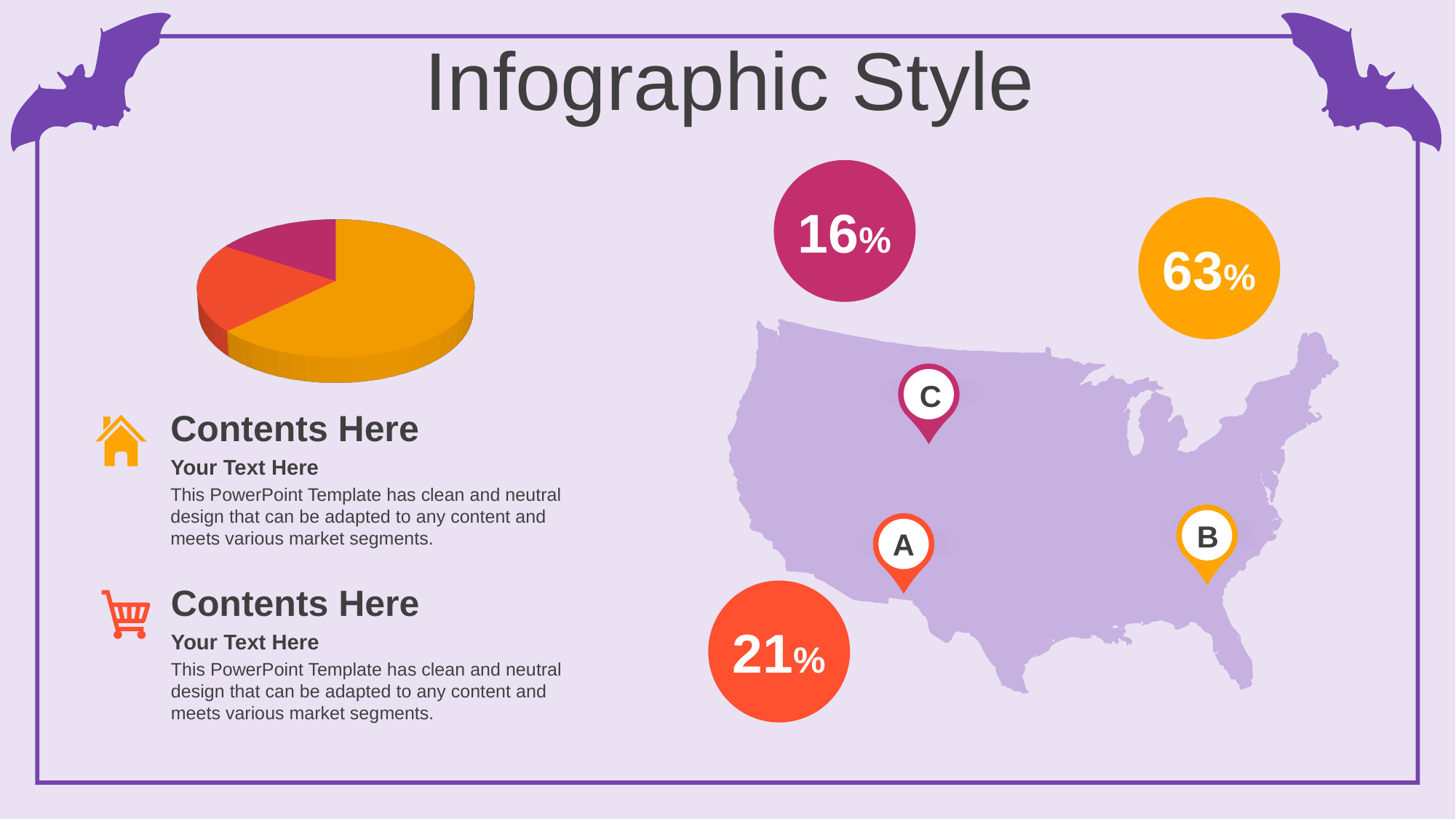
Which colour slice is the largest in the pie chart? orange How many slices does the pie chart have? 3 Is the orange slice of the pie chart greater or less than half of the pie? greater Which colour slice is the smallest in the pie chart? magenta In the pie chart, which slice is larger, the red slice or the magenta slice? red Does the pie chart have a legend? No Is the pie chart drawn in 3D or flat 2D? 3D What kind of chart is shown on the left of the slide? pie chart